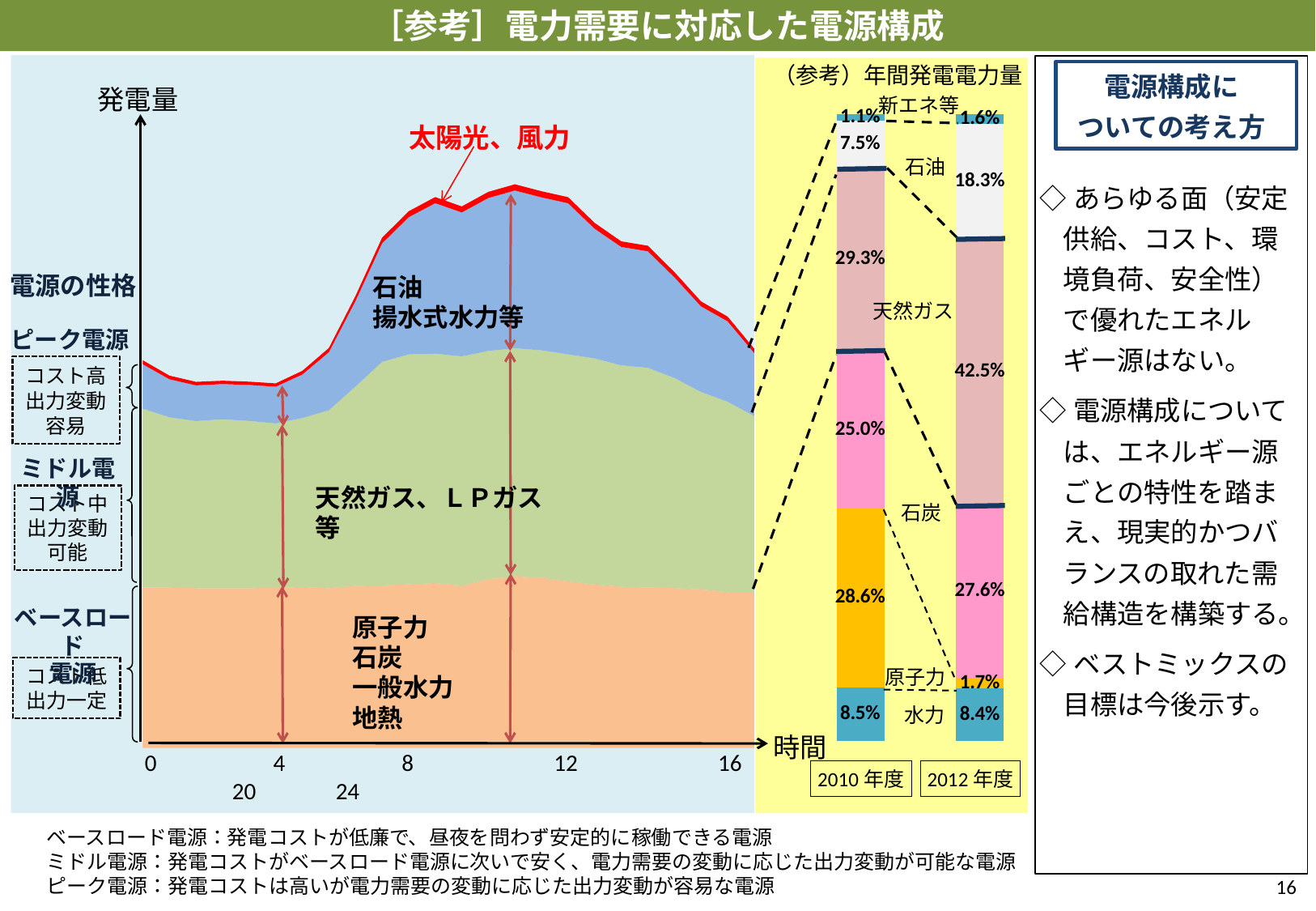
In the stacked bar chart titled （参考）年間発電電力量, what is the share of 石油 in 2012年度? 18.3% In the stacked bar chart titled （参考）年間発電電力量, what is the share of 天然ガス in 2012年度? 42.5% In the stacked bar chart titled （参考）年間発電電力量, by how many percentage points did the share of 石油 change from 2010年度 to 2012年度? 10.8 percentage points In the stacked bar chart titled （参考）年間発電電力量, what is the share of 天然ガス in 2010年度? 29.3% In the stacked bar chart titled （参考）年間発電電力量, which energy source has the largest share in 2012年度? 天然ガス In the stacked bar chart titled （参考）年間発電電力量, what is the share of 原子力 in 2012年度? 1.7% In the stacked bar chart titled （参考）年間発電電力量, how many energy source segments make up each bar? 6 What kind of chart is the left-hand chart with axes 発電量 and 時間? Stacked area chart In the stacked bar chart titled （参考）年間発電電力量, how many fiscal years are compared? 2 In the stacked bar chart titled （参考）年間発電電力量, which energy source has the smallest share in 2010年度? 新エネ等 In the stacked bar chart titled （参考）年間発電電力量, which is larger: the share of 石炭 in 2010年度 or in 2012年度? 2012年度 In the stacked bar chart titled （参考）年間発電電力量, what is the share of 原子力 in 2010年度? 28.6%